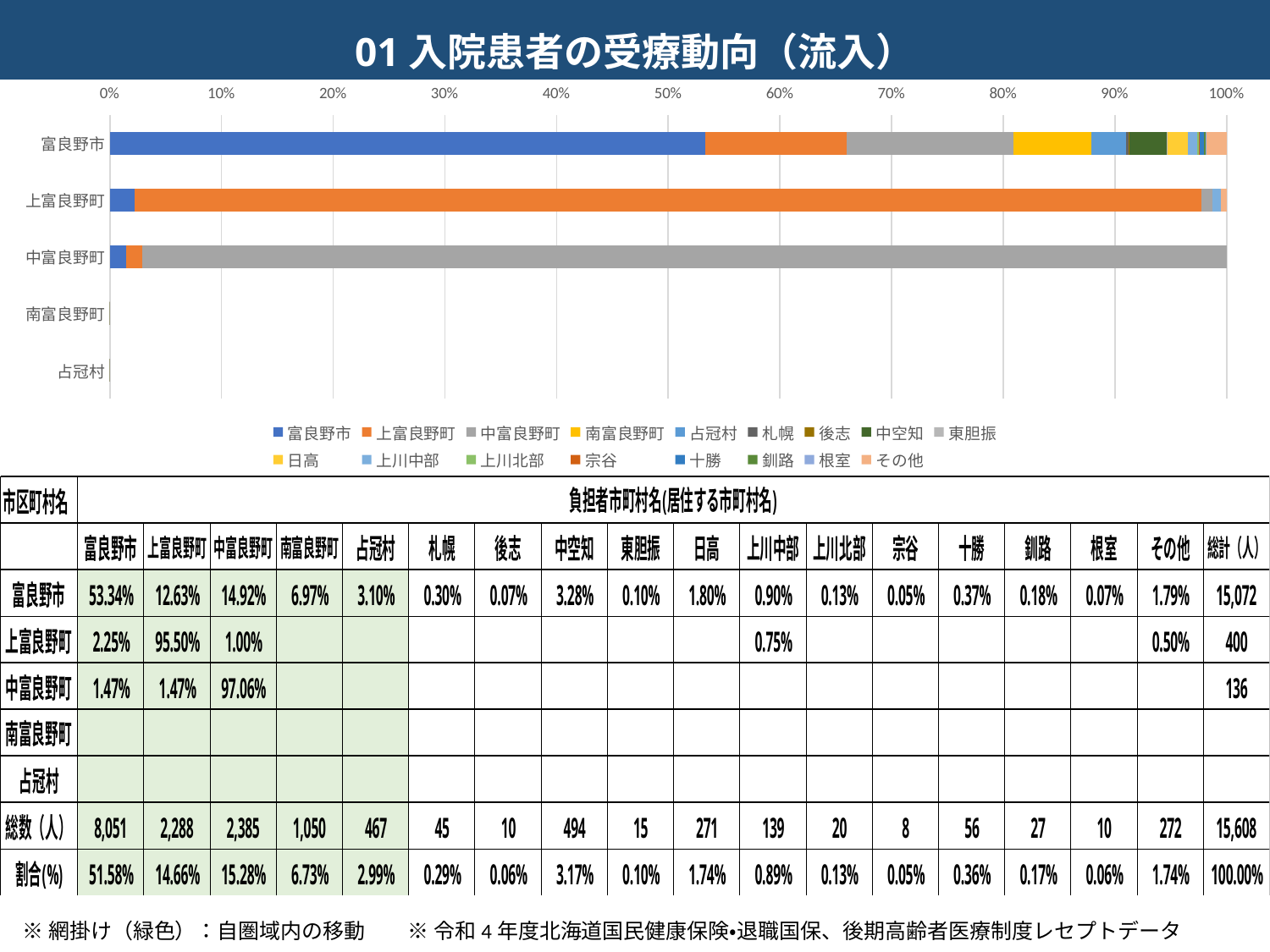
According to the table, what share of 富良野市 inpatients come from 富良野市 itself? 53.34% In the 富良野市 bar, which is larger: the 上富良野町 share (12.63%) or the 中富良野町 share (14.92%)? 中富良野町 How many categories (municipalities) are plotted on the vertical axis of the chart? 5 What kind of chart is shown on the slide? Stacked bar chart According to the table, what share of 上富良野町 inpatients come from 上富良野町 itself? 95.50% What is the maximum value shown on the horizontal axis of the chart? 100% How many series does the chart legend list? 17 Is the 富良野市 segment of the 富良野市 bar greater or less than 50%? greater What is the title of the chart on the slide? 01 入院患者の受療動向（流入） What is the difference between the 上富良野町 share (95.50%) and the 富良野市 share (2.25%) in the 上富良野町 bar? 93.25% According to the table, what share of 中富良野町 inpatients come from 中富良野町 itself? 97.06% Is the 上富良野町 segment of the 上富良野町 bar greater or less than 90%? greater